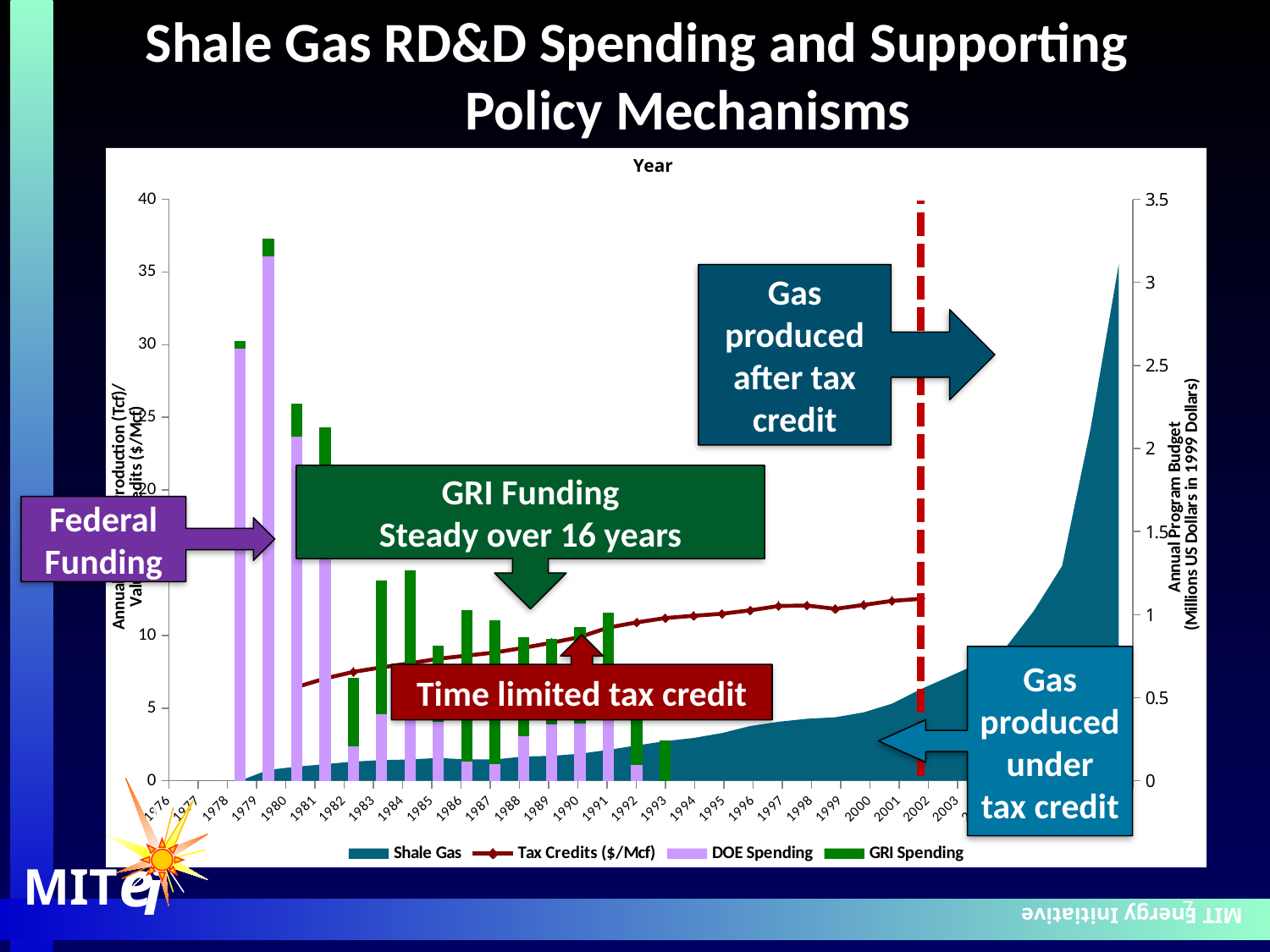
Which legend entry is plotted as a line with markers? Tax Credits ($/Mcf) What kind of chart is shown on the slide? A combination chart with stacked bars, a line and an area Is the total stacked spending bar for 1979 greater or less than 35 on the left axis? greater Which year has the tallest stacked spending bar (DOE plus GRI Spending)? 1979 How many series does the chart legend list? 4 Is the total stacked spending bar for 1980 greater or less than 20 on the left axis? greater Which is larger, the stacked spending bar for 1979 or for 1980? 1979 Is the Tax Credits value in 1981 greater or less than 0.5 on the right axis? greater What is the title of the slide containing the chart? Shale Gas RD&D Spending and Supporting Policy Mechanisms